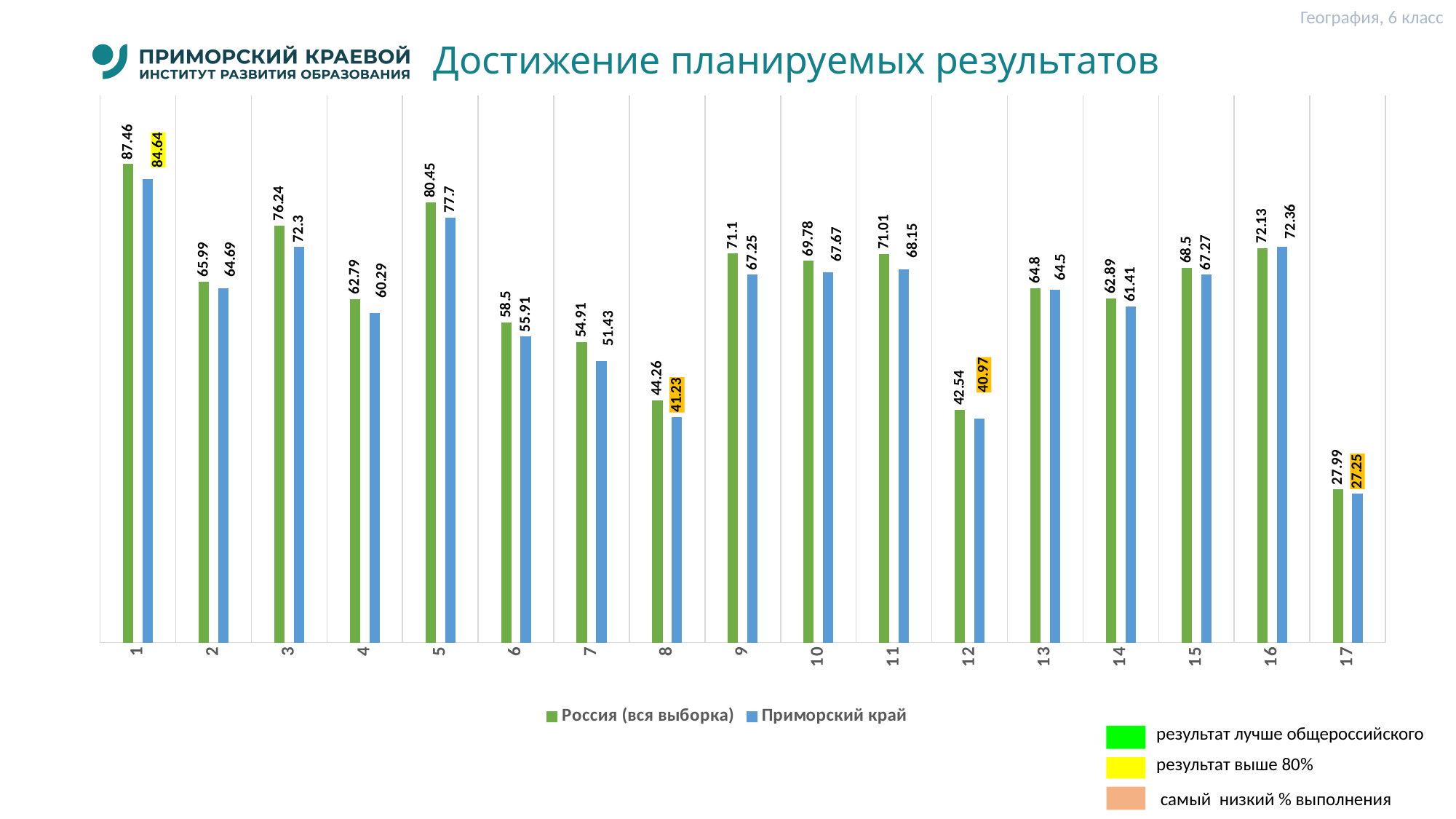
What type of chart is shown on the slide? bar chart What is the value for Россия (вся выборка) for category 5? 80.45 Which is larger: the Приморский край value for category 9 or for category 11? category 11 What is the difference between Россия (вся выборка) and Приморский край for category 3? 3.94 Which category has the lowest value for Приморский край? 17 What is the difference between Россия (вся выборка) and Приморский край for category 8? 3.03 Which category has the highest value for Россия (вся выборка)? 1 How many series does the legend list? 2 For category 16, which series has the larger value: Россия (вся выборка) or Приморский край? Приморский край How many categories are shown on the x axis? 17 What is the value for Приморский край for category 12? 40.97 What is the value for Приморский край for category 1? 84.64